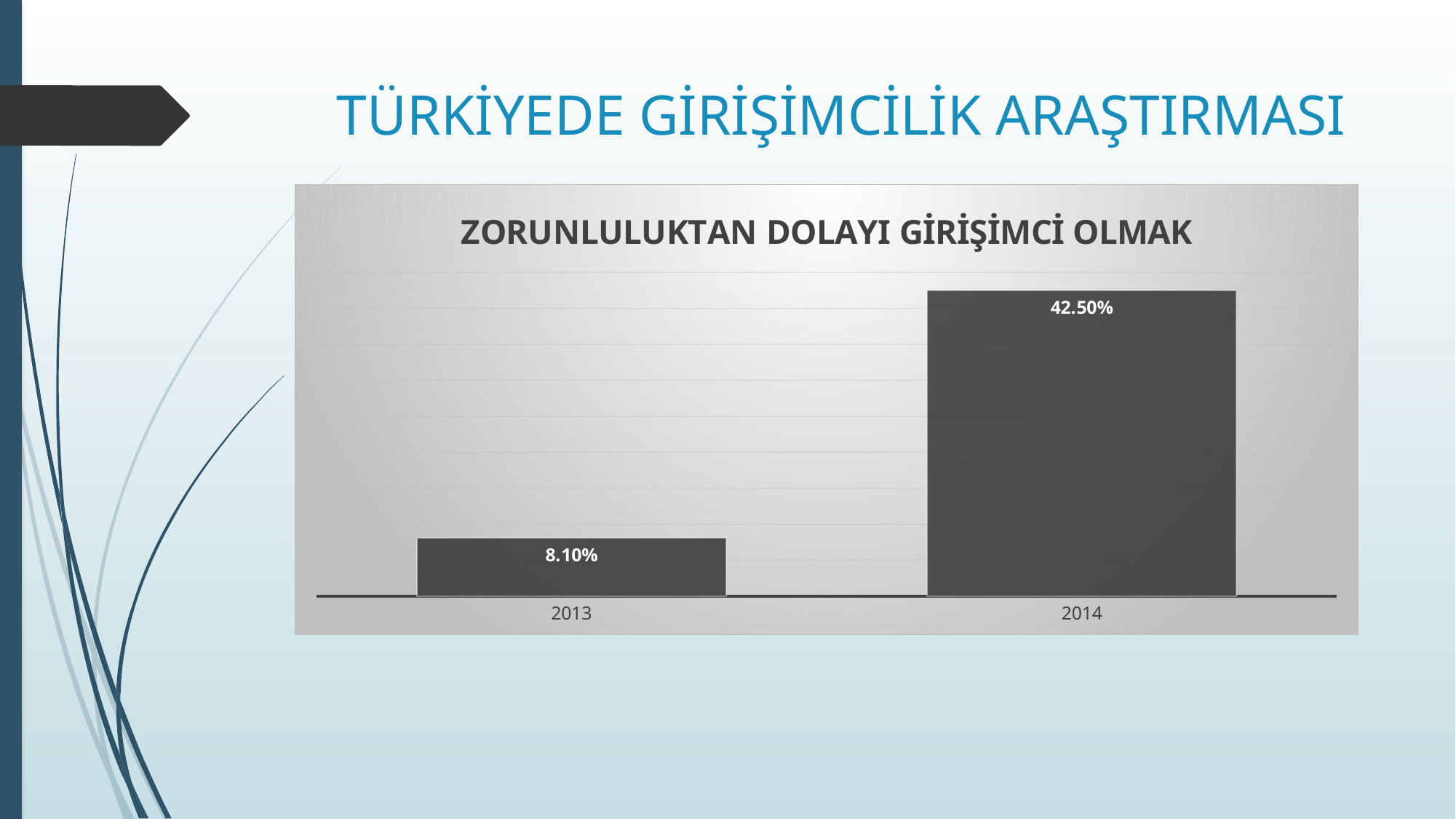
What is the difference between the values for 2014 and 2013? 34.40% What kind of chart is shown on the slide? Bar chart Which year has the lowest value? 2013 Which is larger, the value for 2013 or the value for 2014? 2014 What colour are the bars in the chart? Dark grey How many categories are shown in the chart? 2 What is the title of the chart? ZORUNLULUKTAN DOLAYI GİRİŞİMCİ OLMAK Do the values rise or fall from 2013 to 2014? Rise What is the value for 2014? 42.50% What is the value for 2013? 8.10% Which year has the highest value? 2014